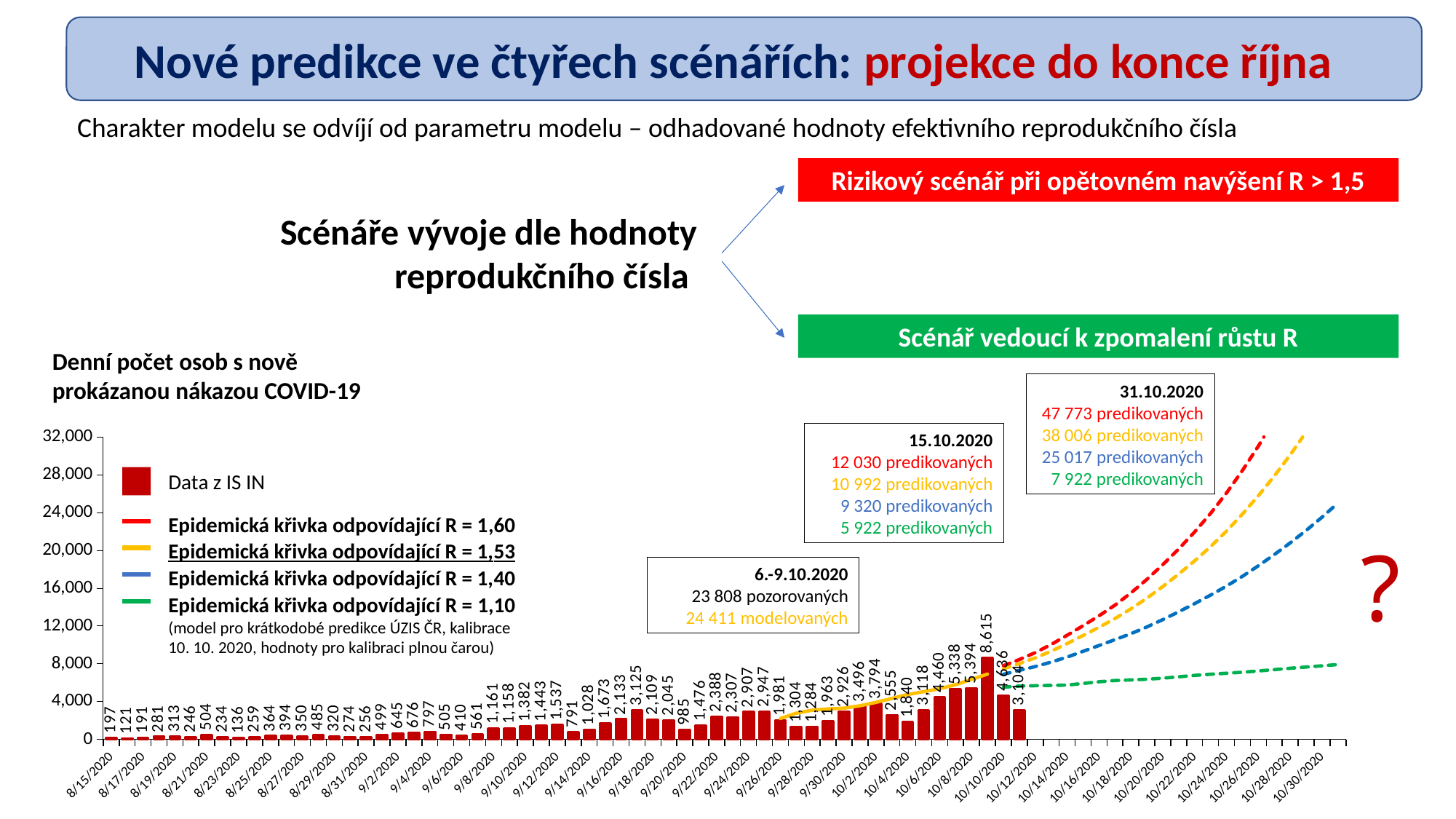
What is the difference between the 31.10.2020 predictions for R = 1,60 (47 773) and R = 1,10 (7 922)? 39 851 What colour is the curve for the scenario R = 1,10? green How many observed cases does the annotation report for 6.-9.10.2020? 23 808 pozorovaných For 15.10.2020, which scenario predicts more cases: R = 1,53 or R = 1,40? R = 1,53 Is the green dashed curve (R = 1,10) at 10/30/2020 greater or less than 12,000? less What is the lowest daily value labelled on the red bars? 121 How many predicted cases does the annotation give for 31.10.2020 under the R = 1,60 scenario? 47 773 predikovaných What is the difference between the modelled (24 411) and observed (23 808) values for 6.-9.10.2020? 603 What is the highest daily value shown by the red bars (Data z IS IN)? 8,615 How many entries does the chart legend list? 5 What is the value of the first bar, for 8/15/2020? 197 How many predicted cases does the annotation give for 15.10.2020 under the R = 1,10 scenario? 5 922 predikovaných